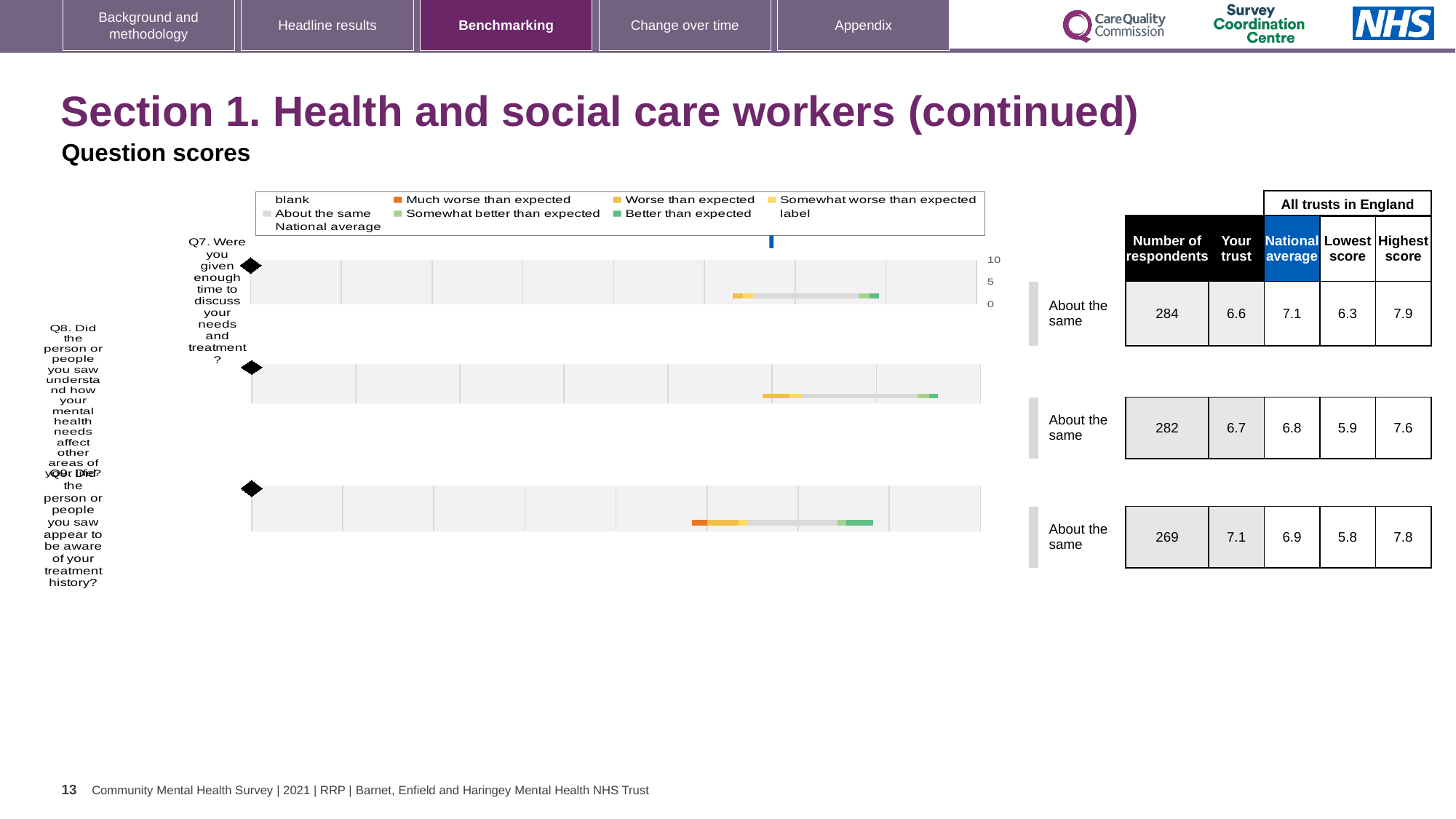
What kind of chart is used to show the question scores? Bar chart Which question has the highest 'Your trust' score? Q9 What is the difference between the national average and the 'Your trust' score for Q7? 0.5 What is the highest score among all trusts in England for Q7? 7.9 For Q9, which is larger: the 'Your trust' score or the national average? Your trust How many questions are charted on this slide? 3 What is the national average score for Q9 (Did the person or people you saw appear to be aware of your treatment history?)? 6.9 What is the lowest score among all trusts in England for Q9? 5.8 What is the 'Your trust' score for Q8 (Did the person or people you saw understand how your mental health needs affect other areas of your life?)? 6.7 How many respondents answered Q7 (Were you given enough time to discuss your needs and treatment?)? 284 What benchmark category is shown for Q8? About the same Which question has the fewest respondents? Q9